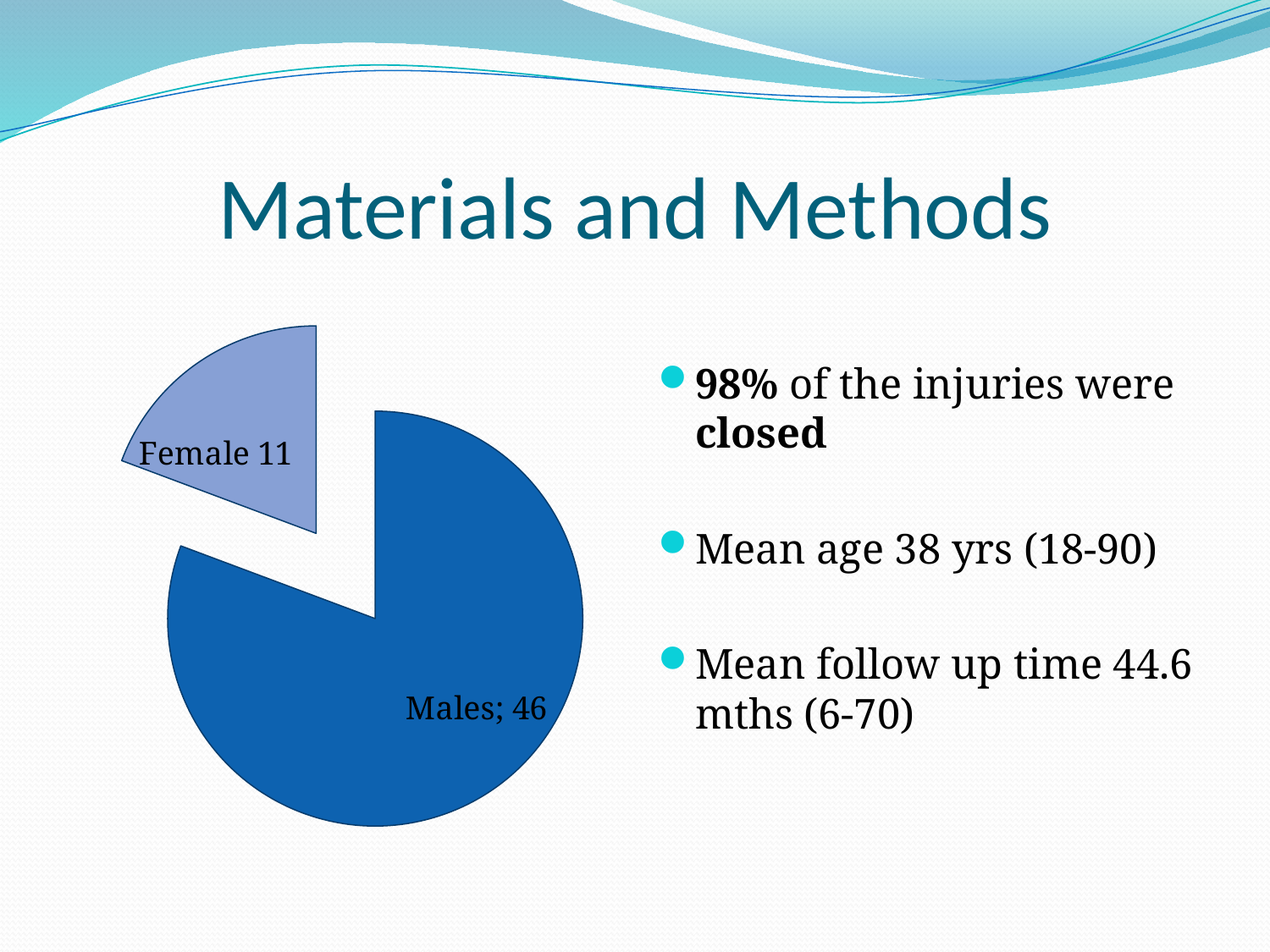
What is the value for Males in the pie chart? 46 What kind of chart is shown on the slide? pie chart Which is larger in the pie chart, Males or Female? Males What is the difference between the Males and Female values in the pie chart? 35 Which slice of the pie chart is the lighter blue colour? Female Which category has the largest slice in the pie chart? Males Which category has the smallest slice in the pie chart? Female What is the total of all slices in the pie chart? 57 Which slice of the pie chart is pulled out (exploded) from the rest? Female What is the value for Female in the pie chart? 11 How many slices does the pie chart have? 2